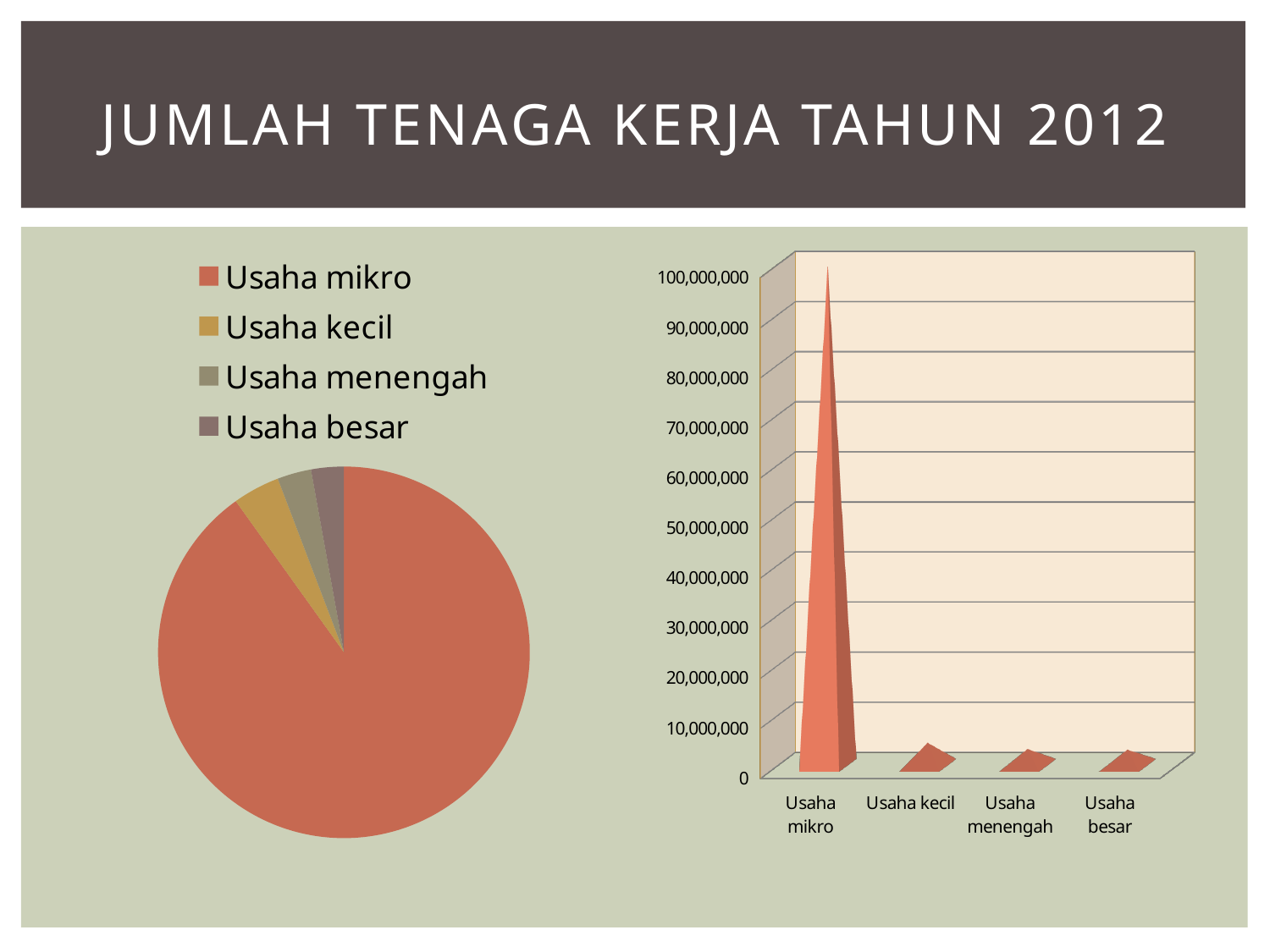
What kind of chart is on the right side of the slide? bar chart How many entries does the legend of the pie chart on the left list? 4 In the bar chart on the right, is the value for Usaha mikro greater or less than 90,000,000? greater In the bar chart on the right, is the value for Usaha kecil greater or less than 10,000,000? less What kind of chart is on the left side of the slide? pie chart In the bar chart on the right, which is larger, the value for Usaha mikro or the value for Usaha menengah? Usaha mikro How many categories are shown on the x axis of the bar chart on the right? 4 In the pie chart on the left, which category has the largest slice? Usaha mikro In the bar chart on the right, is the value for Usaha besar greater or less than 10,000,000? less In the bar chart on the right, which category has the highest value? Usaha mikro What is the title of the slide containing the charts? JUMLAH TENAGA KERJA TAHUN 2012 In the pie chart on the left, what colour is the Usaha mikro slice? red